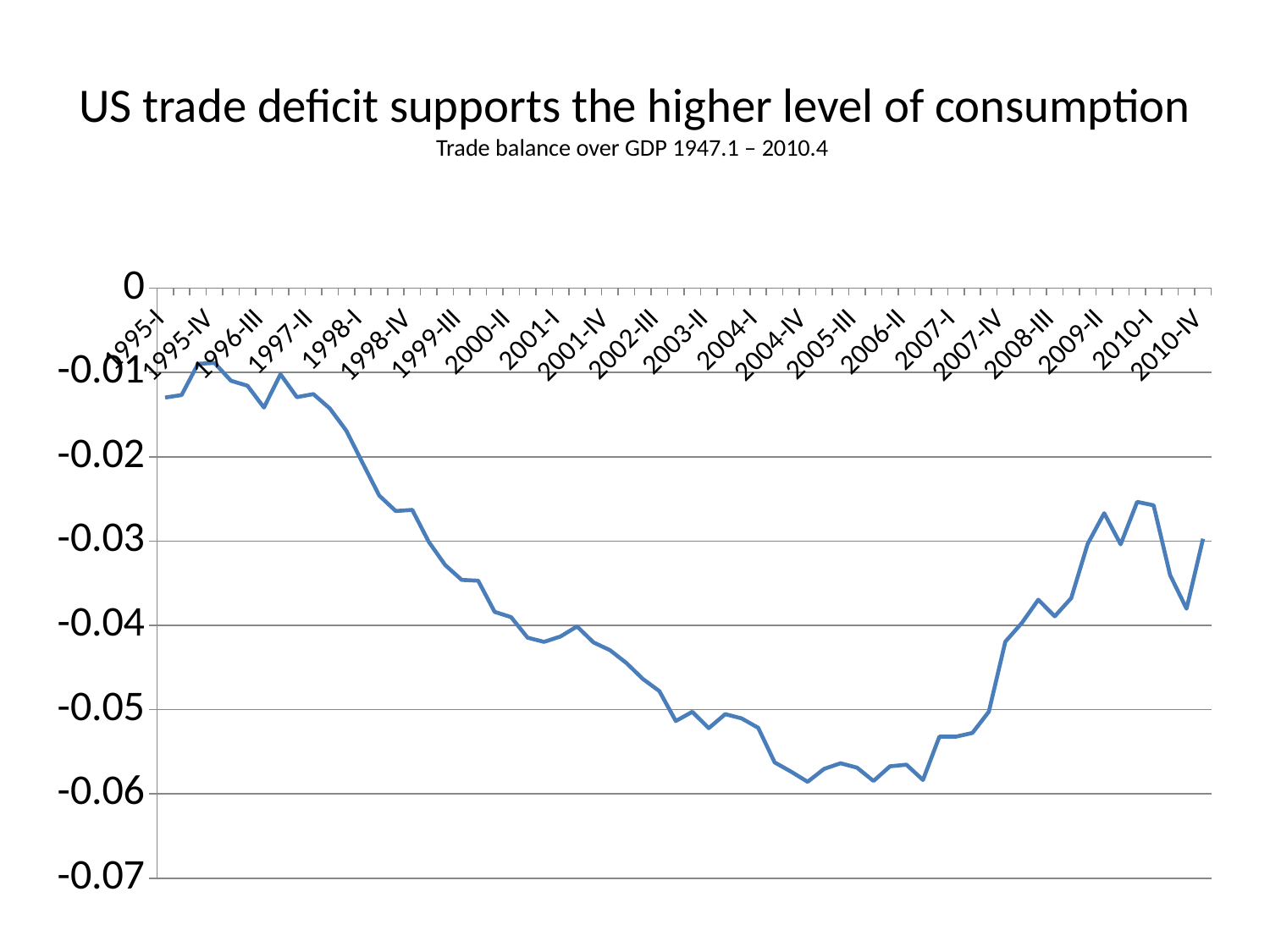
Is the value for 2009-II greater or less than -0.03? greater Which has the lower trade balance over GDP, 1995-I or 2005-III? 2005-III Which has the higher trade balance over GDP, 1997-II or 2002-III? 1997-II Does the trade balance over GDP rise or fall from 2006-II to 2009-II? rise What is the title of the slide? US trade deficit supports the higher level of consumption What kind of chart is shown on the slide? line chart How many quarter labels are shown on the x axis? 22 What period does the chart subtitle say the trade balance over GDP covers? 1947.1 – 2010.4 Is the value for 2004-IV greater or less than -0.05? less Is the value for 1995-I greater or less than -0.02? greater Does the trade balance over GDP rise or fall from 1995-I to 2004-IV? fall